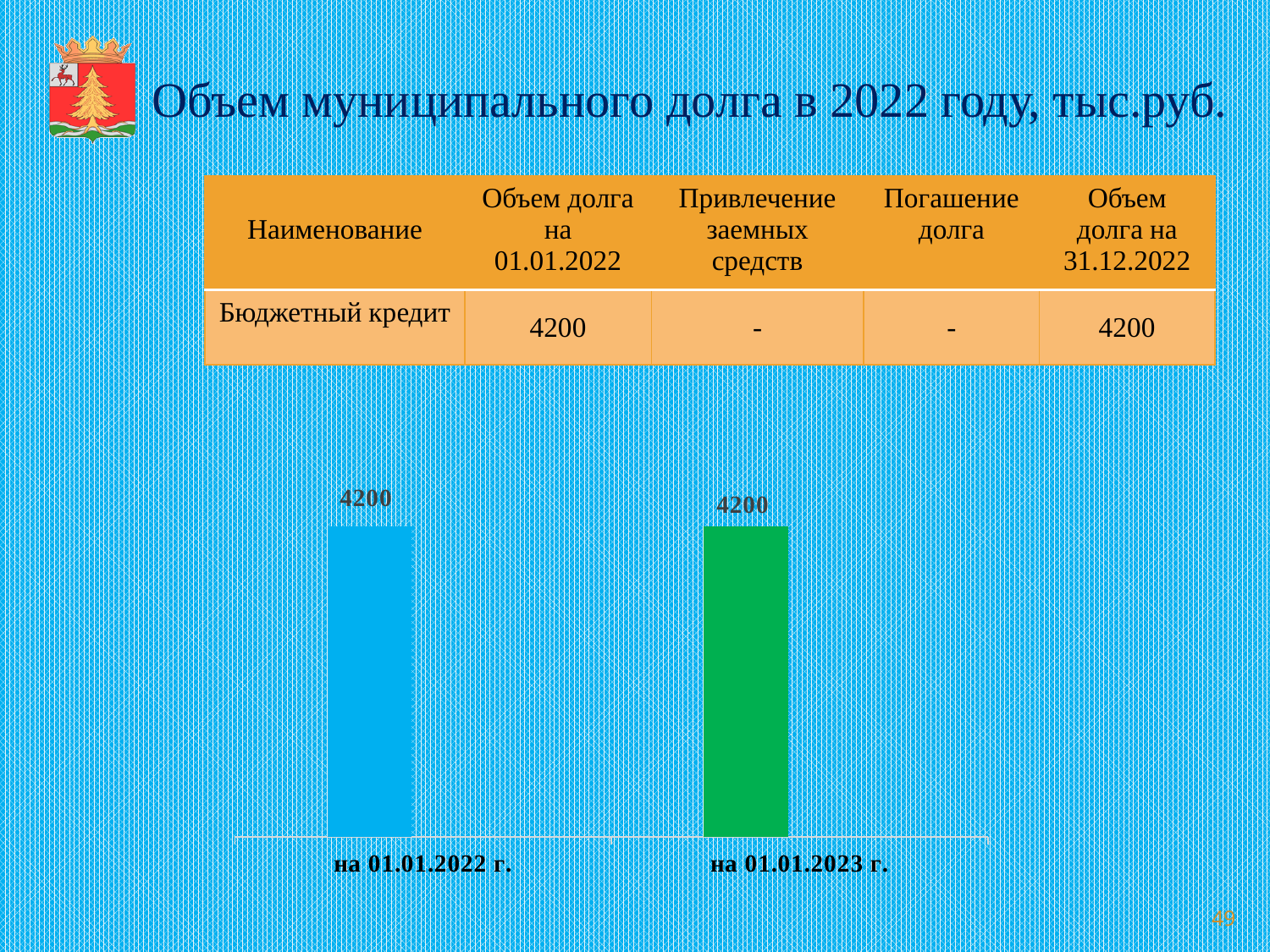
What is the label of the first (left) bar on the x axis? на 01.01.2022 г. What is the difference between the values for "на 01.01.2022 г." and "на 01.01.2023 г."? 0 What colour is the bar for "на 01.01.2022 г."? Blue What kind of chart is shown on the slide? Bar chart Do the values rise, fall or stay the same from "на 01.01.2022 г." to "на 01.01.2023 г."? Stay the same How many bars are shown in the chart? 2 What is the label of the second (right) bar on the x axis? на 01.01.2023 г. What colour is the bar for "на 01.01.2023 г."? Green What is the value of the bar for "на 01.01.2022 г."? 4200 What is the value of the bar for "на 01.01.2023 г."? 4200 Are the values for "на 01.01.2022 г." and "на 01.01.2023 г." equal? Yes